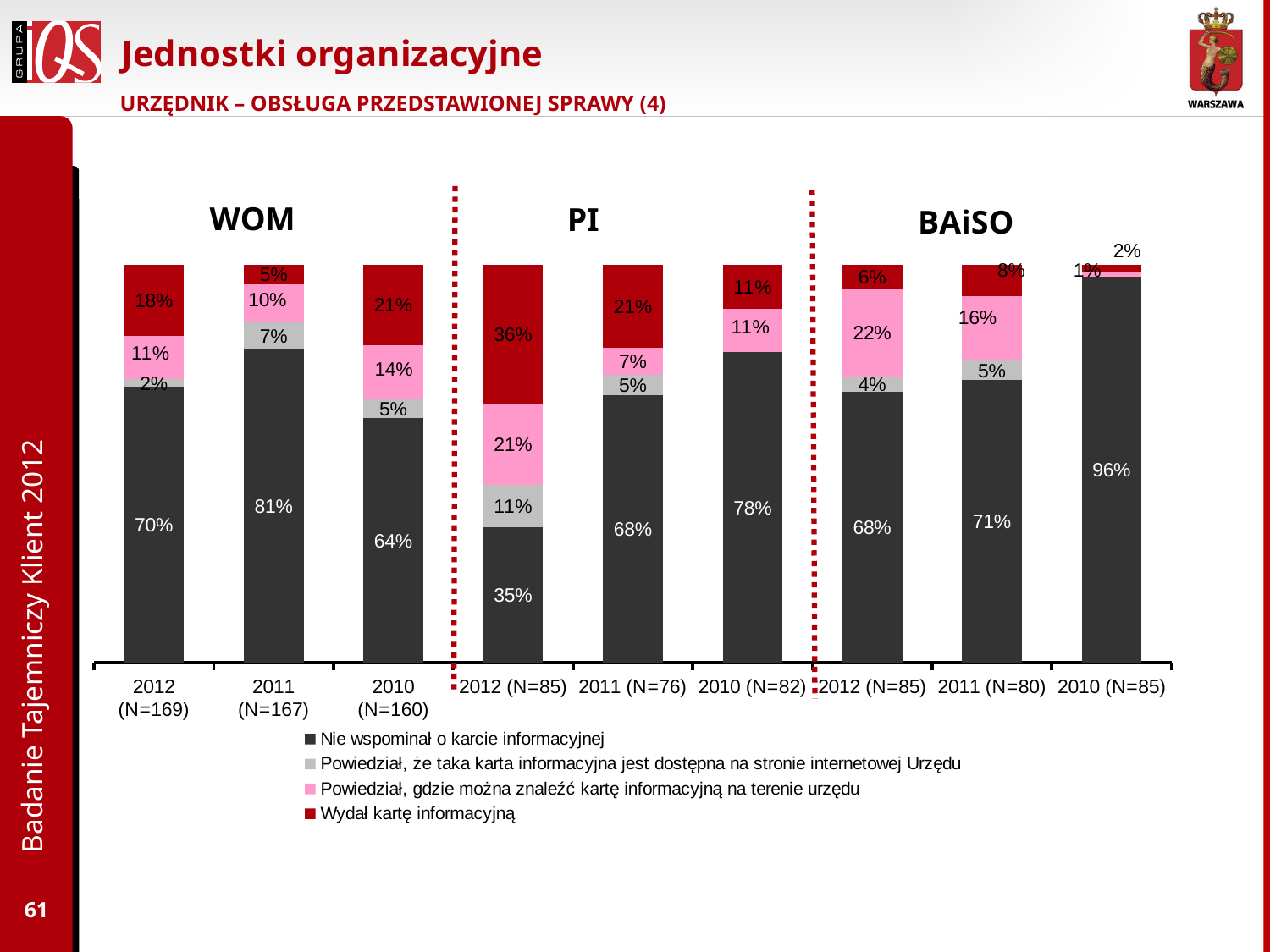
How many series does the legend list? 4 How many bars are plotted in the chart? 9 What is the value of 'Powiedział, gdzie można znaleźć kartę informacyjną na terenie urzędu' for BAiSO 2012 (N=85)? 22% What is the value of 'Nie wspominał o karcie informacyjnej' for PI 2012 (N=85)? 35% What is the value of 'Powiedział, że taka karta informacyjna jest dostępna na stronie internetowej Urzędu' for PI 2012 (N=85)? 11% Which bar has the highest value for 'Nie wspominał o karcie informacyjnej'? BAiSO 2010 (N=85) Which is larger: the 'Nie wspominał o karcie informacyjnej' value for WOM 2011 (N=167) or for BAiSO 2011 (N=80)? WOM 2011 (N=167) Which three organisational units are labelled above the groups of bars? WOM, PI, BAiSO Which bar has the lowest value for 'Nie wspominał o karcie informacyjnej'? PI 2012 (N=85) What kind of chart is shown on the slide? stacked bar chart What is the difference between the 'Wydał kartę informacyjną' values for PI 2012 (N=85) and PI 2011 (N=76)? 15% What is the value of 'Wydał kartę informacyjną' for WOM 2010 (N=160)? 21%